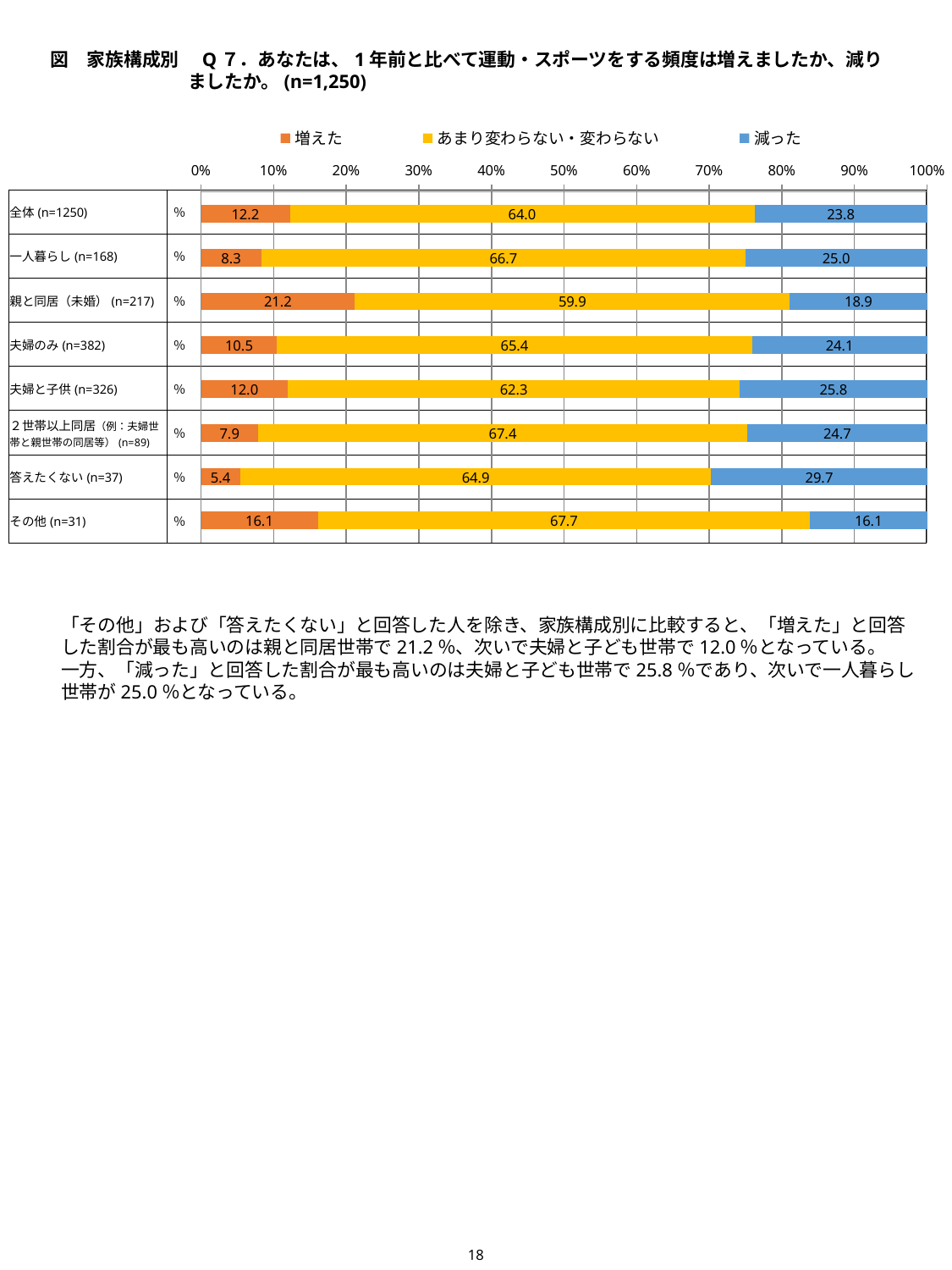
Which category has the lowest value for 増えた? 答えたくない (n=37) Which is larger, the 増えた value for 夫婦のみ (n=382) or for 夫婦と子供 (n=326)? 夫婦と子供 (n=326) Which category has the highest value for 増えた? 親と同居（未婚）(n=217) How many series does the legend list? 3 Which category has the lowest value for 減った? その他 (n=31) What is the difference between 減った and 増えた for 全体 (n=1250)? 11.6 What is the value of 減った for 答えたくない (n=37)? 29.7 What is the total of the stacked bar for 一人暮らし (n=168)? 100.0 What is the value of あまり変わらない・変わらない for 夫婦のみ (n=382)? 65.4 What is the value of 増えた for 全体 (n=1250)? 12.2 What kind of chart is shown on the slide? Stacked bar chart How many categories are shown in the chart? 8